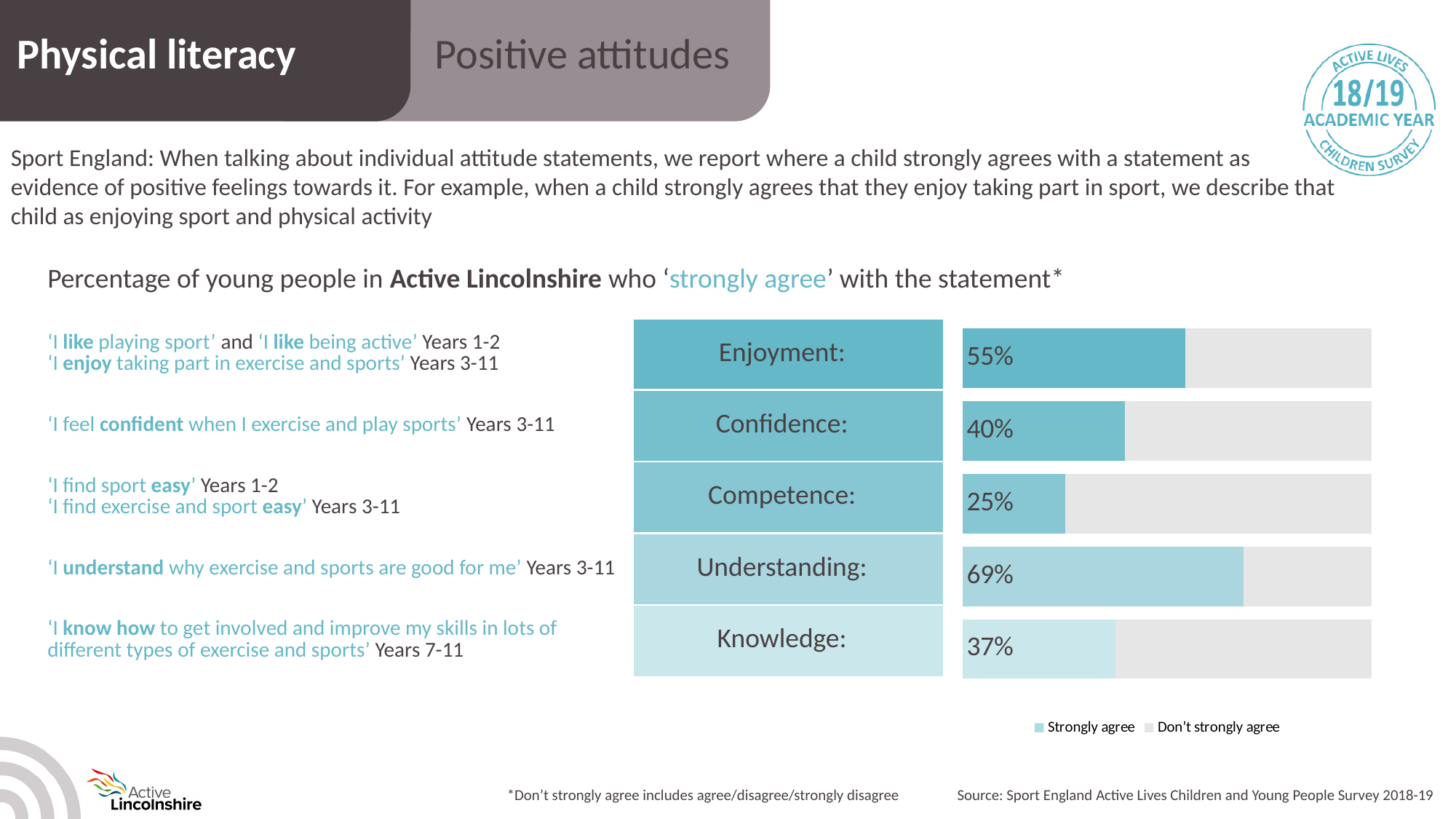
What is the difference in percentage points between Understanding and Competence? 44 Which attitude category has the lowest percentage of young people who strongly agree? Competence Which has a higher percentage of strong agreement, Confidence or Knowledge? Confidence What are the two legend entries of the chart? Strongly agree; Don't strongly agree What percentage strongly agree with the Knowledge statement? 37% Which attitude category has the highest percentage of young people who strongly agree? Understanding How many attitude categories are shown in the chart? 5 What percentage of young people in Active Lincolnshire strongly agree with the Enjoyment statement? 55% What percentage strongly agree with the Confidence statement? 40% How many series does the chart legend list? 2 What kind of chart is used to show the percentages? Bar chart What is the difference in percentage points between Enjoyment and Confidence? 15